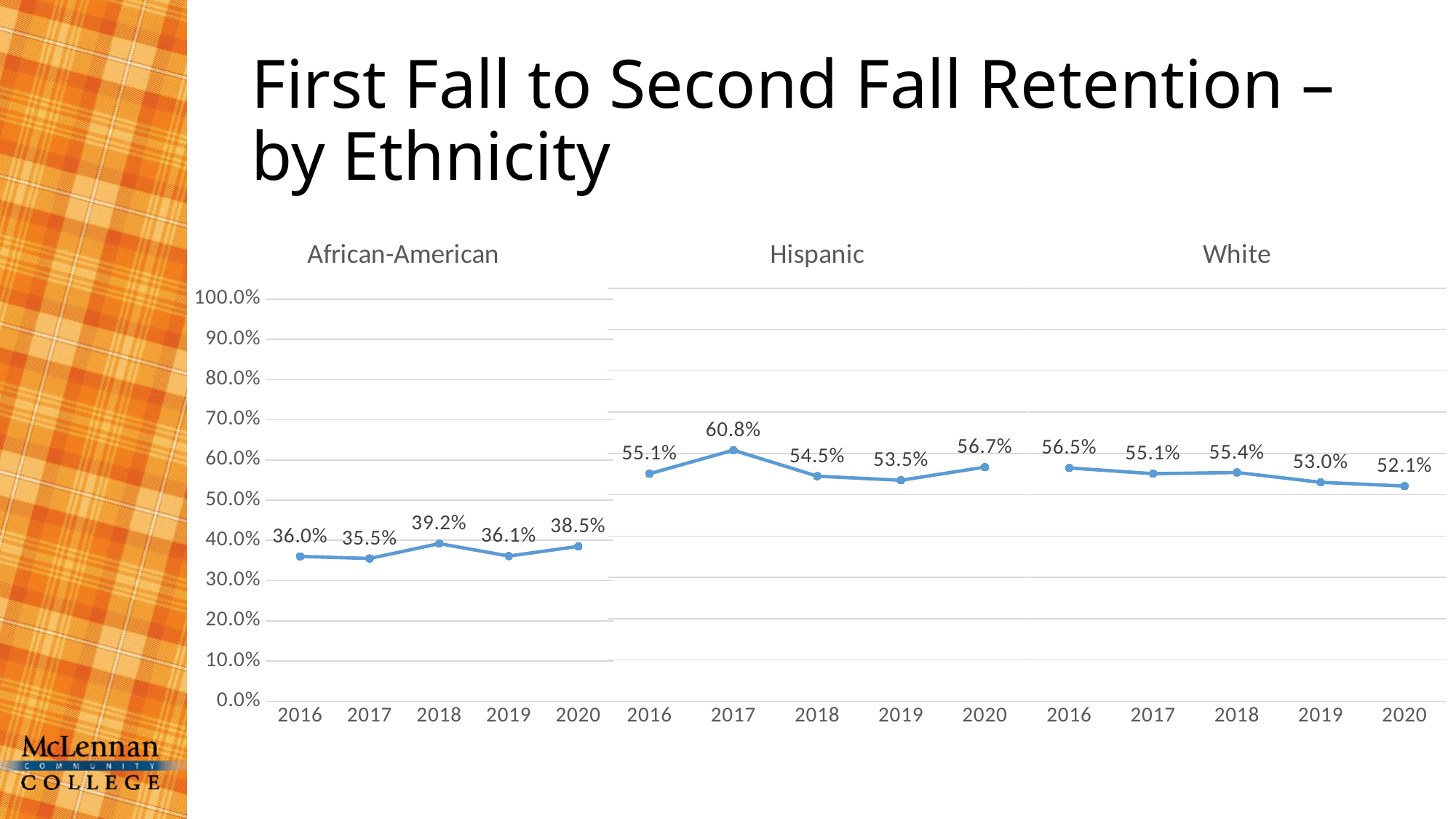
Is the African-American retention rate in 2019 greater or less than 40.0%? less What kind of chart is shown on the slide? Line chart What is the retention rate for White students in 2020? 52.1% What is the retention rate for Hispanic students in 2017? 60.8% Which is larger: the White retention rate in 2016 or the Hispanic retention rate in 2016? White retention rate in 2016 Which year has the highest retention rate for Hispanic students? 2017 What is the retention rate for African-American students in 2018? 39.2% How many years are plotted for each ethnicity group? 5 What is the difference between the Hispanic retention rate in 2017 and in 2018? 6.3% Which year has the lowest retention rate for African-American students? 2017 Which year has the lowest retention rate for White students? 2020 Do the White retention rates rise or fall from 2018 to 2020? Fall